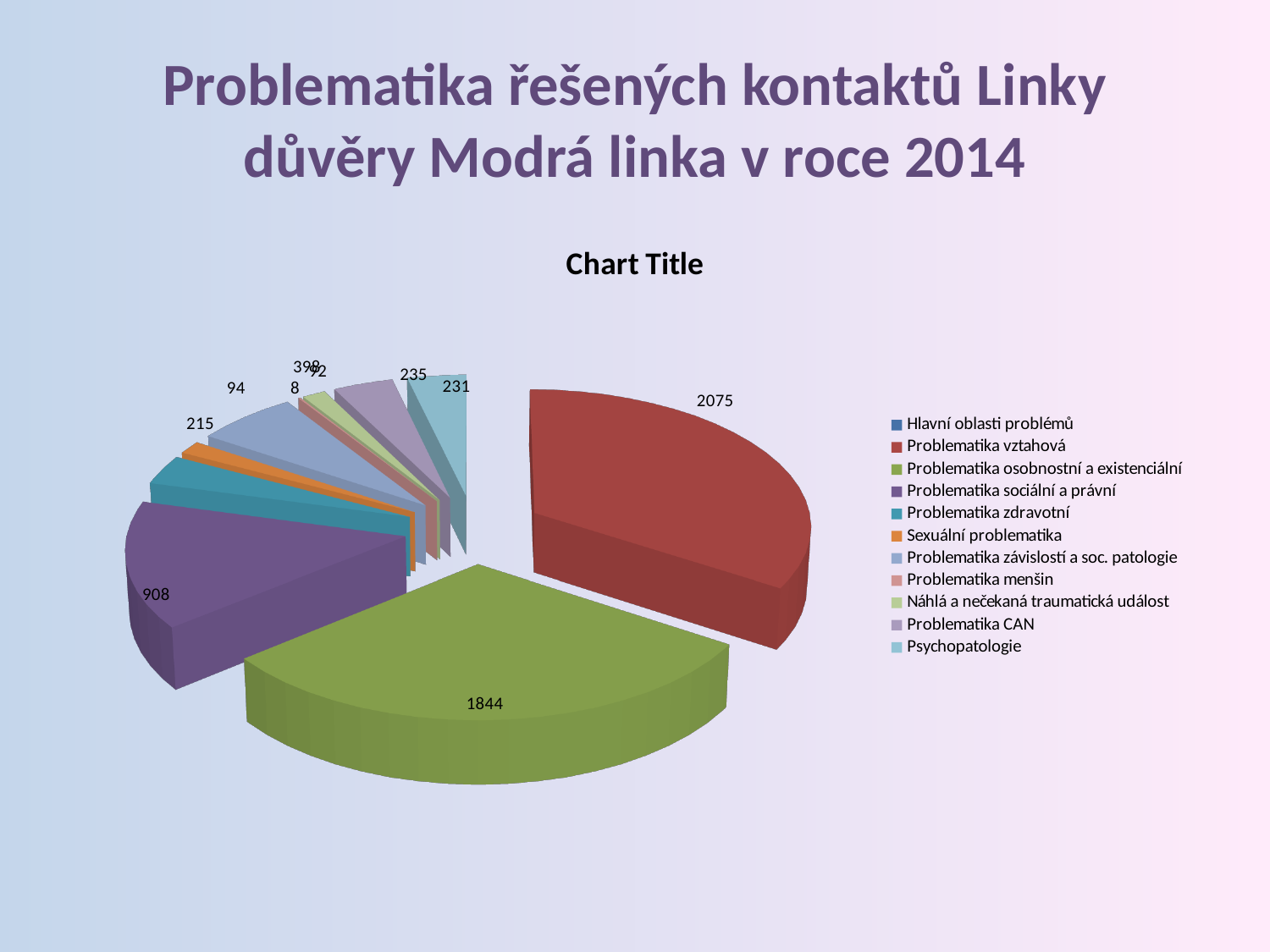
What is the difference between the values for Problematika vztahová and Problematika osobnostní a existenciální? 231 Which is larger, the value for Problematika sociální a právní or the value for Problematika zdravotní? Problematika sociální a právní What is the value for Problematika vztahová? 2075 What is the difference between the values for Problematika sociální a právní and Problematika zdravotní? 693 Which category has the largest slice of the pie? Problematika vztahová What is the value for Problematika CAN? 235 What is the title shown above the pie chart? Chart Title What is the value for Psychopatologie? 231 What is the value for Problematika osobnostní a existenciální? 1844 What kind of chart is shown on the slide? pie chart What is the value for Problematika zdravotní? 215 What is the value for Problematika sociální a právní? 908